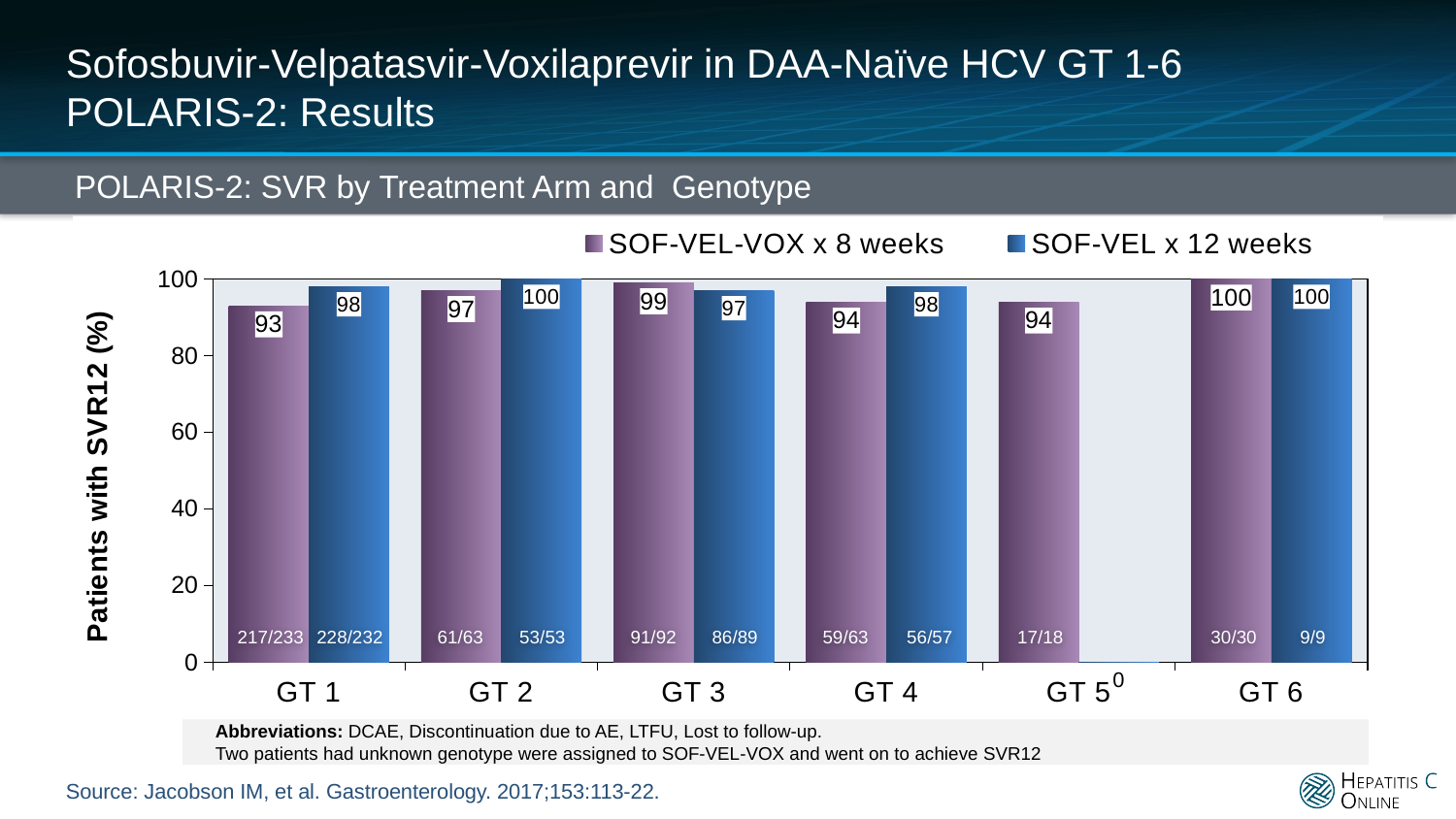
What is the title of the chart? POLARIS-2: SVR by Treatment Arm and Genotype What is the SVR12 rate for SOF-VEL x 12 weeks in GT 4? 98 What is the SVR12 rate for SOF-VEL-VOX x 8 weeks in GT 1? 93 What is the SVR12 rate for SOF-VEL-VOX x 8 weeks in GT 3? 99 In GT 3, which treatment arm has the higher SVR12 rate? SOF-VEL-VOX x 8 weeks What is the patient fraction shown for SOF-VEL-VOX x 8 weeks in GT 1? 217/233 What kind of chart is shown on the slide? Bar chart How many genotype categories are shown on the x axis? 6 How many series does the legend list? 2 Which genotype has the lowest SVR12 rate for SOF-VEL-VOX x 8 weeks? GT 1 What is the difference between the SOF-VEL x 12 weeks and SOF-VEL-VOX x 8 weeks SVR12 rates in GT 1? 5 What is the SVR12 rate for SOF-VEL x 12 weeks in GT 2? 100